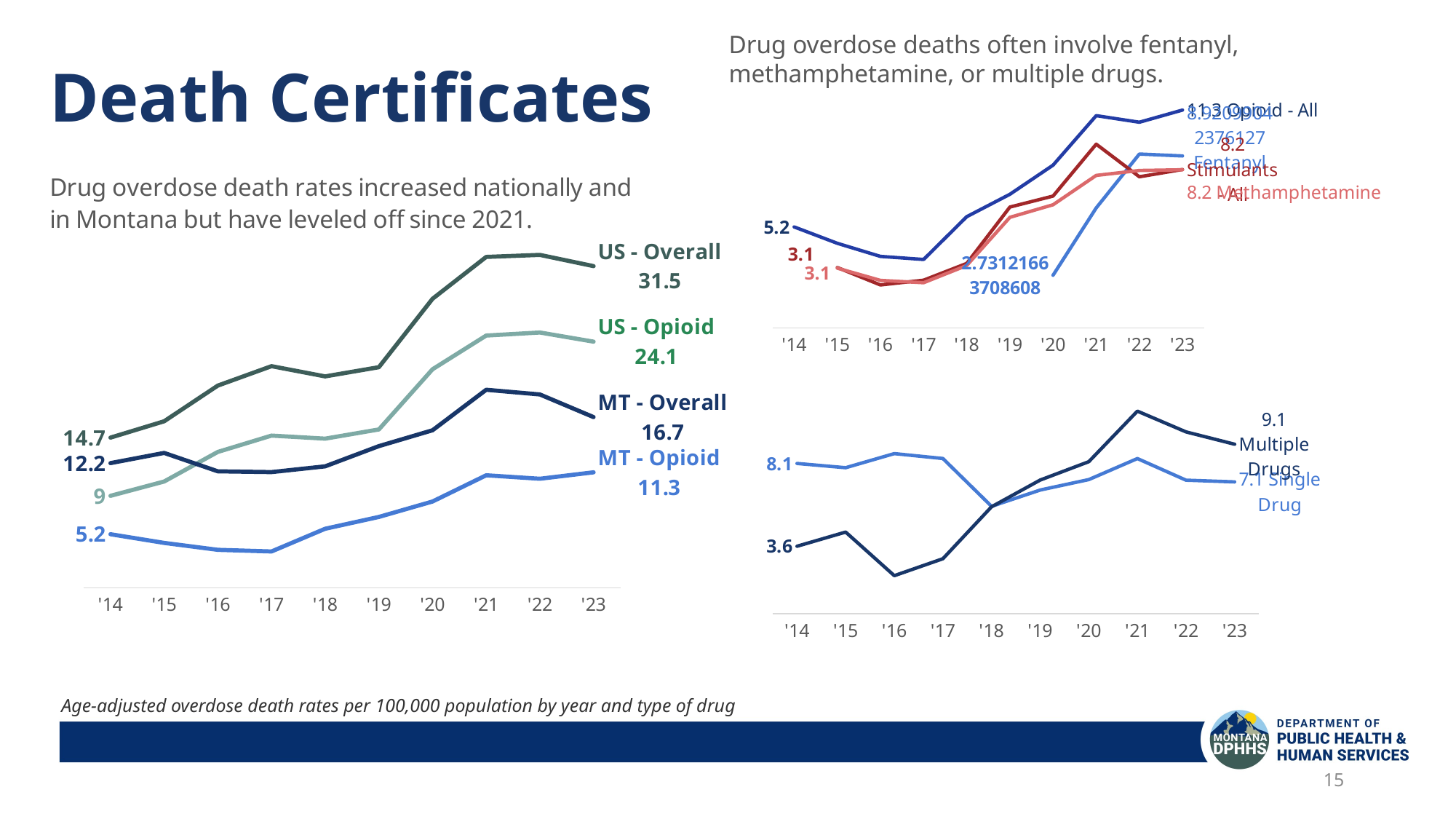
What kind of chart is the left chart? Line chart In the left chart, does the MT - Opioid rate rise or fall overall from 2014 to 2023? Rise In the left chart, what is the MT - Overall rate in 2023? 16.7 In the left chart, which series has the highest value in 2023? US - Overall In the left chart, what is the MT - Opioid rate in 2014? 5.2 In the left chart, which series has the lowest value in 2023? MT - Opioid In the left chart, what is the difference between the US - Overall and MT - Overall rates in 2023? 14.8 In the bottom-right chart, which is higher in 2014, Multiple Drugs or Single Drug? Single Drug In the left chart, what is the US - Overall overdose death rate in 2023? 31.5 In the bottom-right chart, how many years are shown on the x axis? 10 In the left chart, how many series are plotted? 4 In the bottom-right chart, what is the Multiple Drugs rate in 2023? 9.1